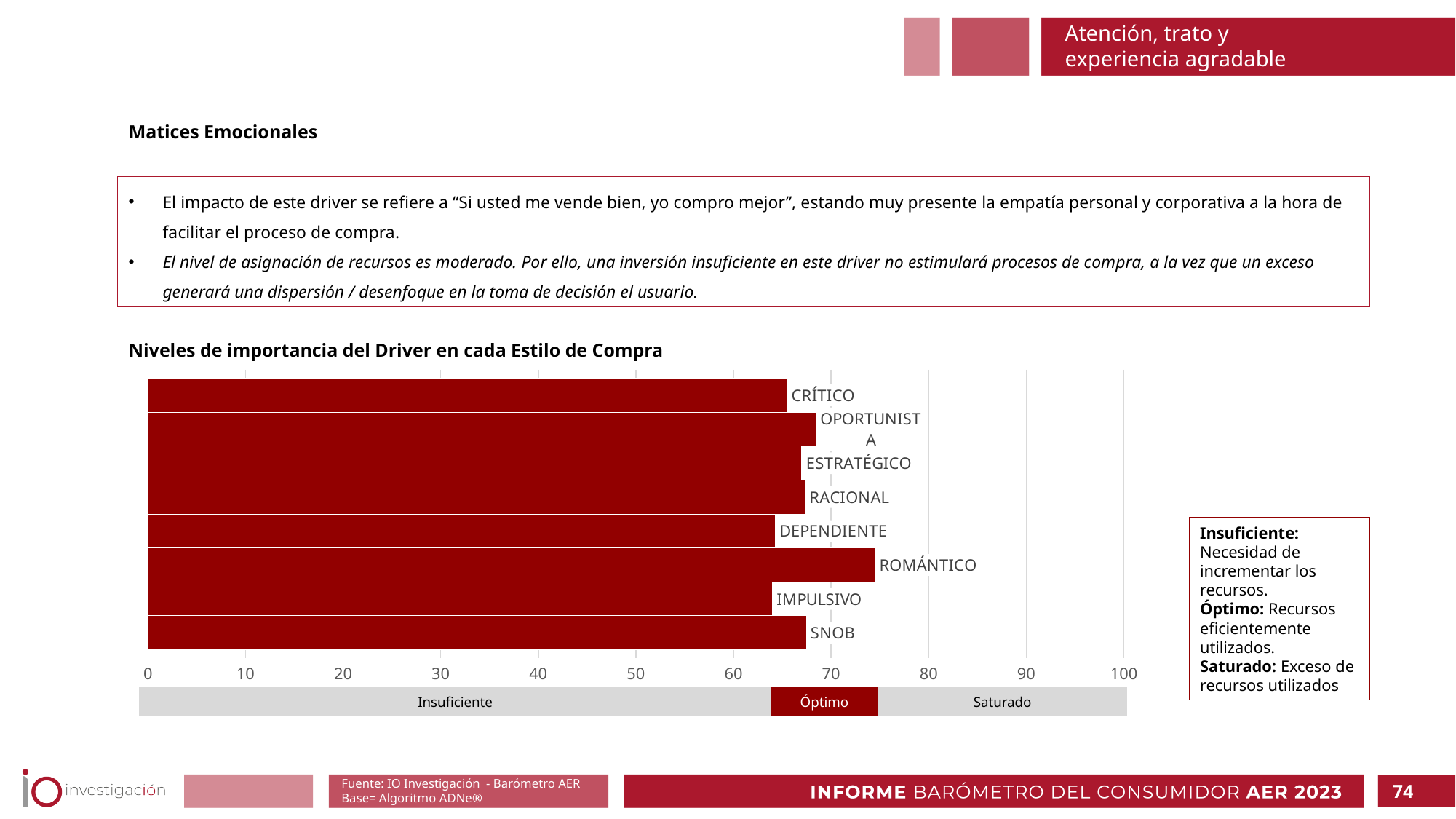
Is the value for SNOB greater or less than 50? greater Is the value for ROMÁNTICO greater or less than 70? greater Is the value for DEPENDIENTE greater or less than 60? greater What is the title of the chart on the slide? Niveles de importancia del Driver en cada Estilo de Compra Which is larger, the value for ROMÁNTICO or the value for IMPULSIVO? ROMÁNTICO What are the three zone labels shown in the band below the chart's x axis? Insuficiente, Óptimo, Saturado Which purchase style has the highest value in the chart? ROMÁNTICO Which is larger, the value for ROMÁNTICO or the value for CRÍTICO? ROMÁNTICO What kind of chart is shown under "Niveles de importancia del Driver en cada Estilo de Compra"? Bar chart How many purchase styles (categories) are plotted in the chart? 8